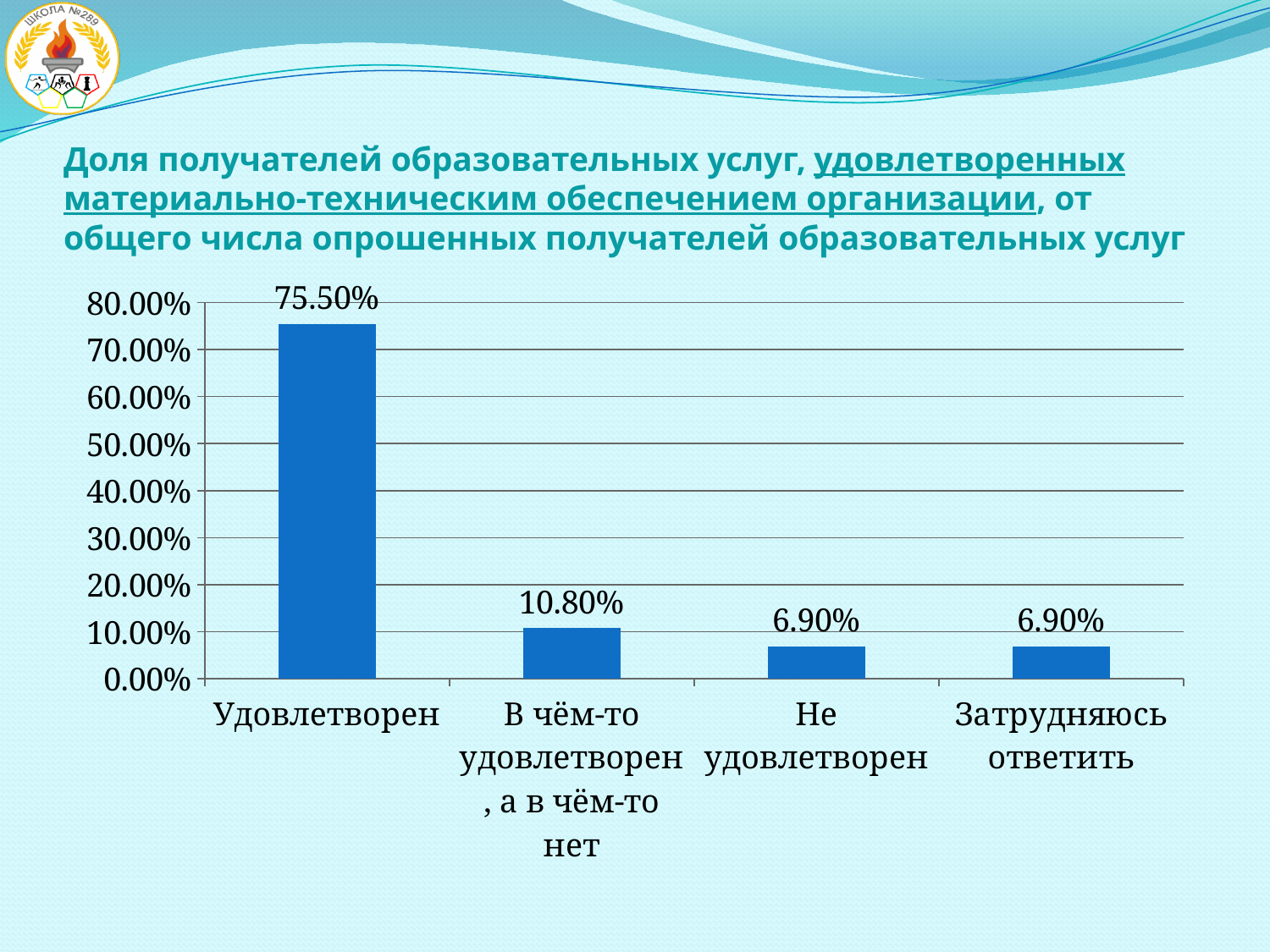
Which category has the highest value? Удовлетворен What is the value for "Затрудняюсь ответить"? 6.90% Which is larger, the value for "Удовлетворен" or the value for "Не удовлетворен"? Удовлетворен What is the value for "В чём-то удовлетворен, а в чём-то нет"? 10.80% What is the value for "Удовлетворен"? 75.50% What is the value for "Не удовлетворен"? 6.90% Is the value for "Затрудняюсь ответить" greater or less than 10.00%? less Is the value for "Удовлетворен" greater or less than 70.00%? greater What kind of chart is shown on the slide? bar chart What is the difference between the values for "Удовлетворен" and "В чём-то удовлетворен, а в чём-то нет"? 64.70% What is the difference between the values for "В чём-то удовлетворен, а в чём-то нет" and "Не удовлетворен"? 3.90% How many categories are shown on the x axis? 4